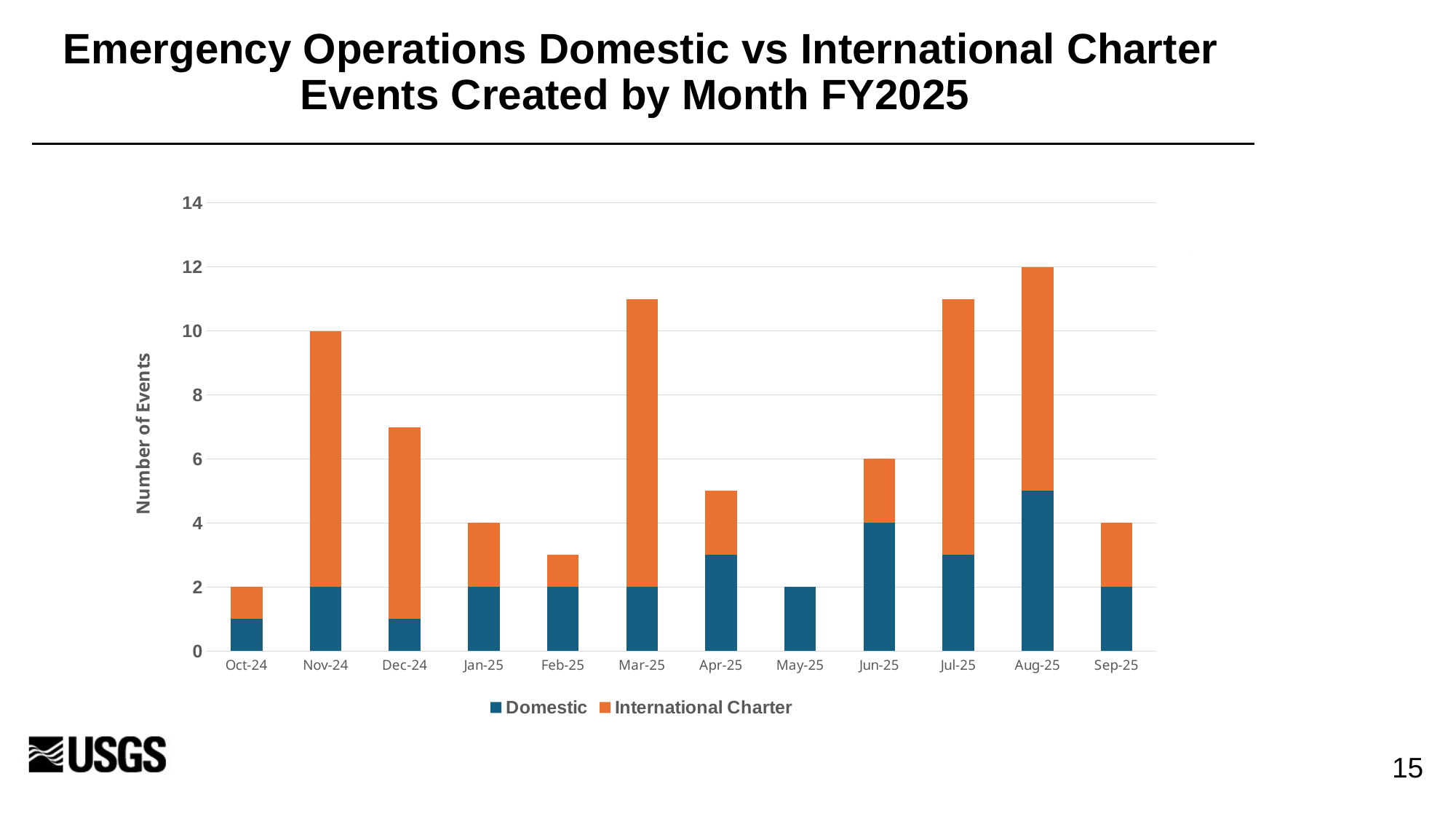
What is the total number of events for Aug-25? 12 What is the title of the y axis? Number of Events What is the total number of events for Nov-24? 10 Is the total number of events for Feb-25 greater or less than 4? less Which month has the highest total number of events? Aug-25 What kind of chart is shown on the slide? Stacked bar chart Is the total number of events for Mar-25 greater or less than 10? greater Which month has the highest Domestic value? Aug-25 How many series does the legend list? 2 What is the Domestic value for Jun-25? 4 How many months are shown on the x axis? 12 Which has a larger total number of events, Nov-24 or Dec-24? Nov-24